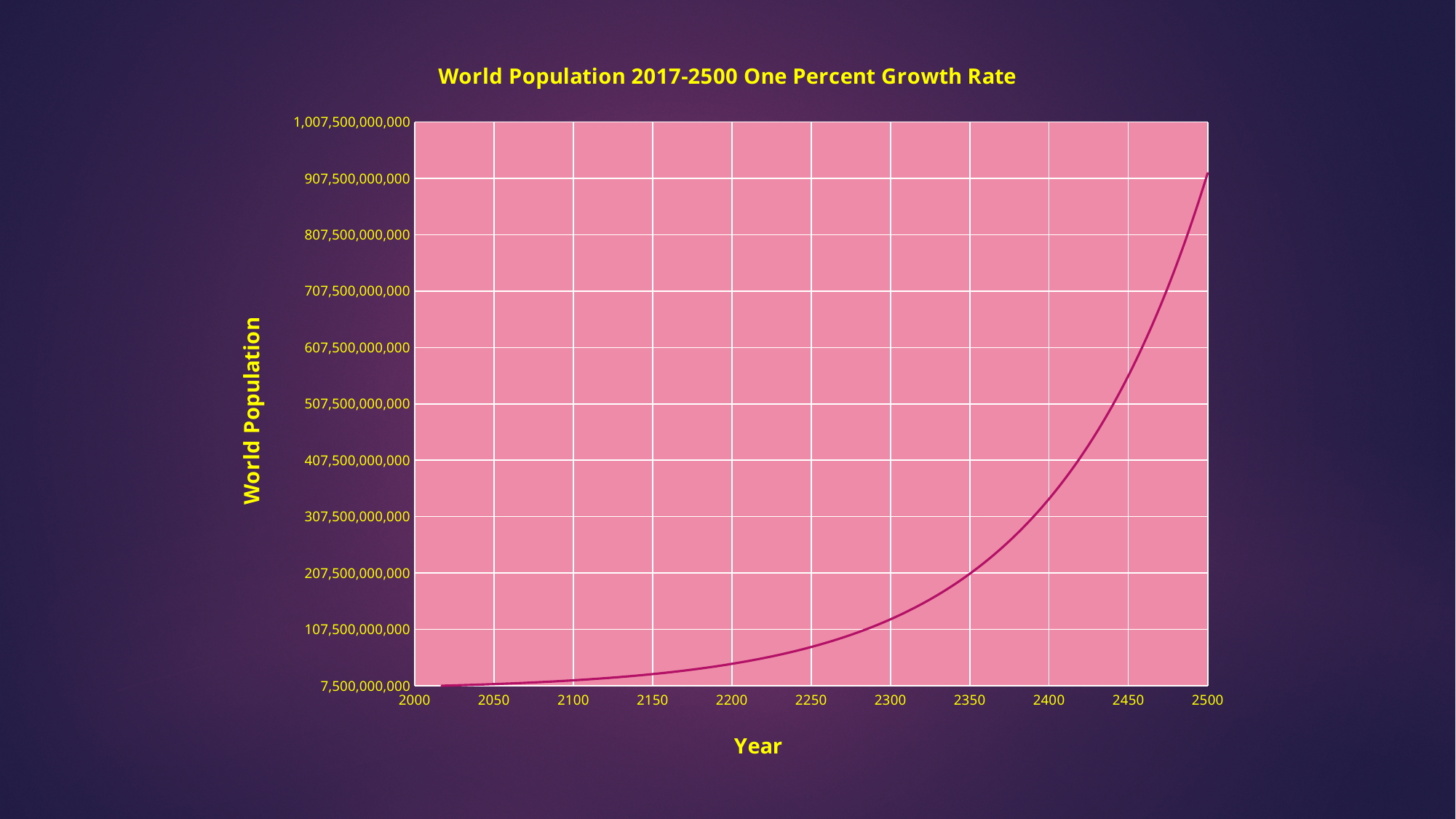
Do the plotted values rise or fall as the year increases along the x axis? rise What kind of chart is shown on the slide? line chart Is the value for the year 2300 greater or less than 207,500,000,000? less Is the value for the year 2400 greater or less than 407,500,000,000? less Which year shown on the x axis has the highest plotted value? 2500 What is the label of the vertical axis? World Population Is the value for the year 2450 greater or less than 607,500,000,000? less What is the title of the chart? World Population 2017-2500 One Percent Growth Rate